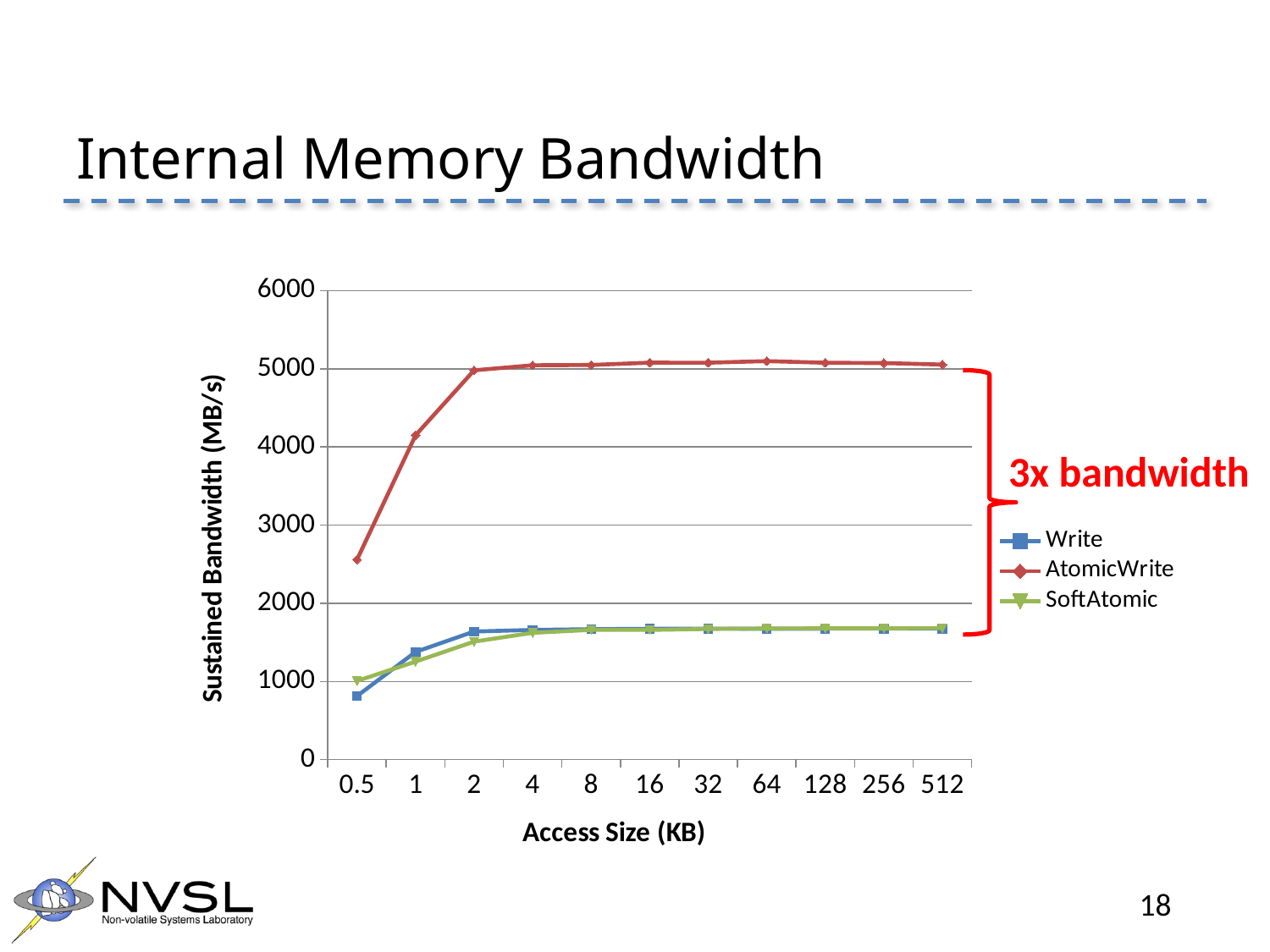
How many access sizes are plotted along the x axis? 11 At an access size of 0.5 KB, which is larger: Write or SoftAtomic? SoftAtomic Which series has the lowest sustained bandwidth at an access size of 0.5 KB? Write Which series has the highest sustained bandwidth at an access size of 512 KB? AtomicWrite Does the AtomicWrite series rise or fall between 0.5 KB and 2 KB? rise Is the value for AtomicWrite at 0.5 KB greater or less than 3000? less Is the value for Write at 0.5 KB greater or less than 1000? less How many series does the legend list? 3 What is the title of the y axis? Sustained Bandwidth (MB/s) Is the value for AtomicWrite at 64 KB greater or less than 4000? greater What kind of chart is shown on the slide? line chart